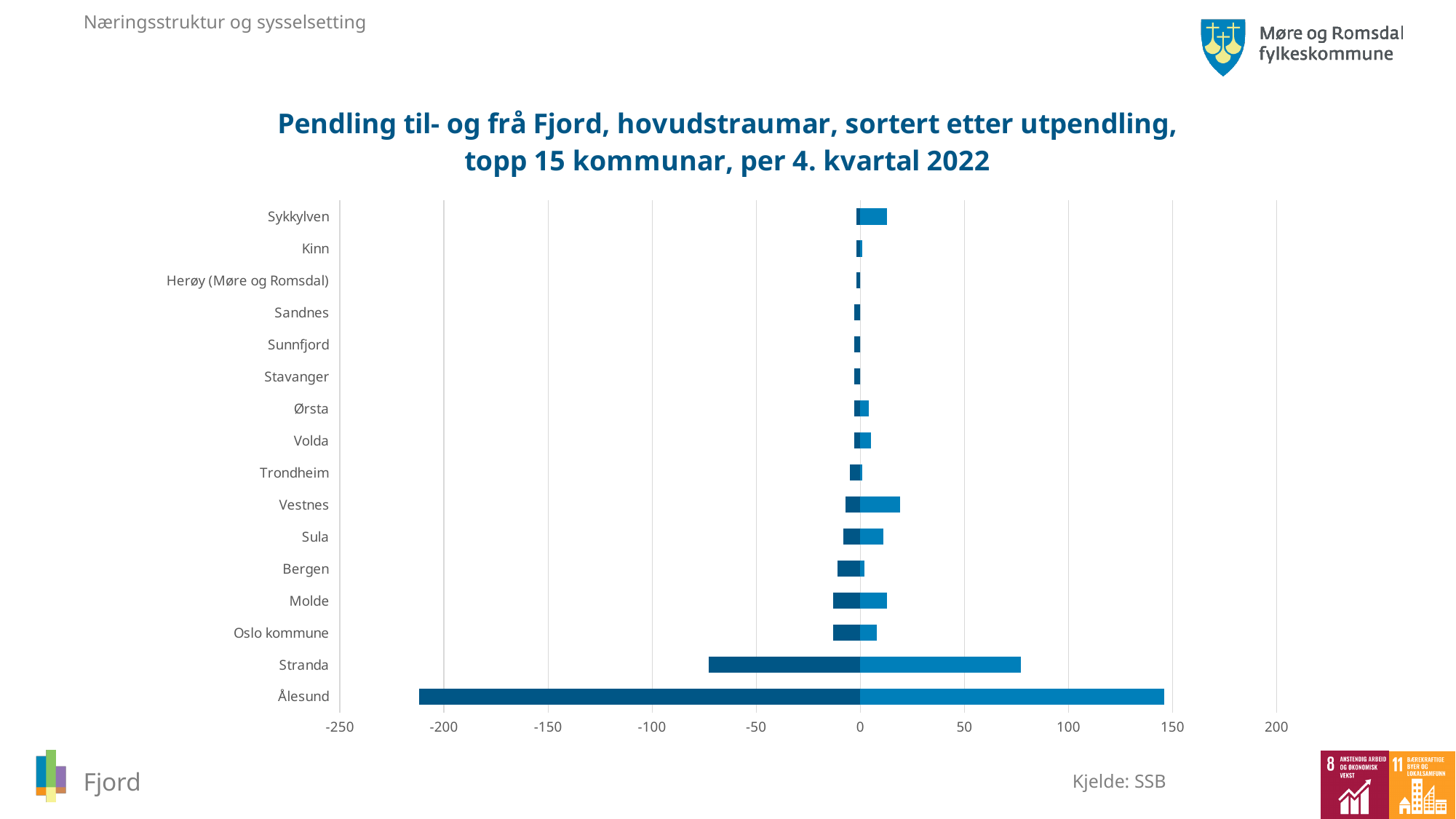
What is the title of the chart? Pendling til- og frå Fjord, hovudstraumar, sortert etter utpendling, topp 15 kommunar, per 4. kvartal 2022 What are the minimum and maximum tick values shown on the horizontal axis? -250 and 200 Is the negative (left-pointing) value for Stranda greater or less than -50? less What kind of chart is shown on the slide? bar chart Which municipality has the longest bars in the chart? Ålesund Which has the larger positive (right-pointing) bar, Ålesund or Stranda? Ålesund Is the positive (right-pointing) value for Vestnes greater or less than 50? less Which has the larger positive (right-pointing) bar, Stranda or Molde? Stranda Is the positive (right-pointing) value for Ålesund greater or less than 100? greater How many municipalities (categories) are listed on the vertical axis of the chart? 16